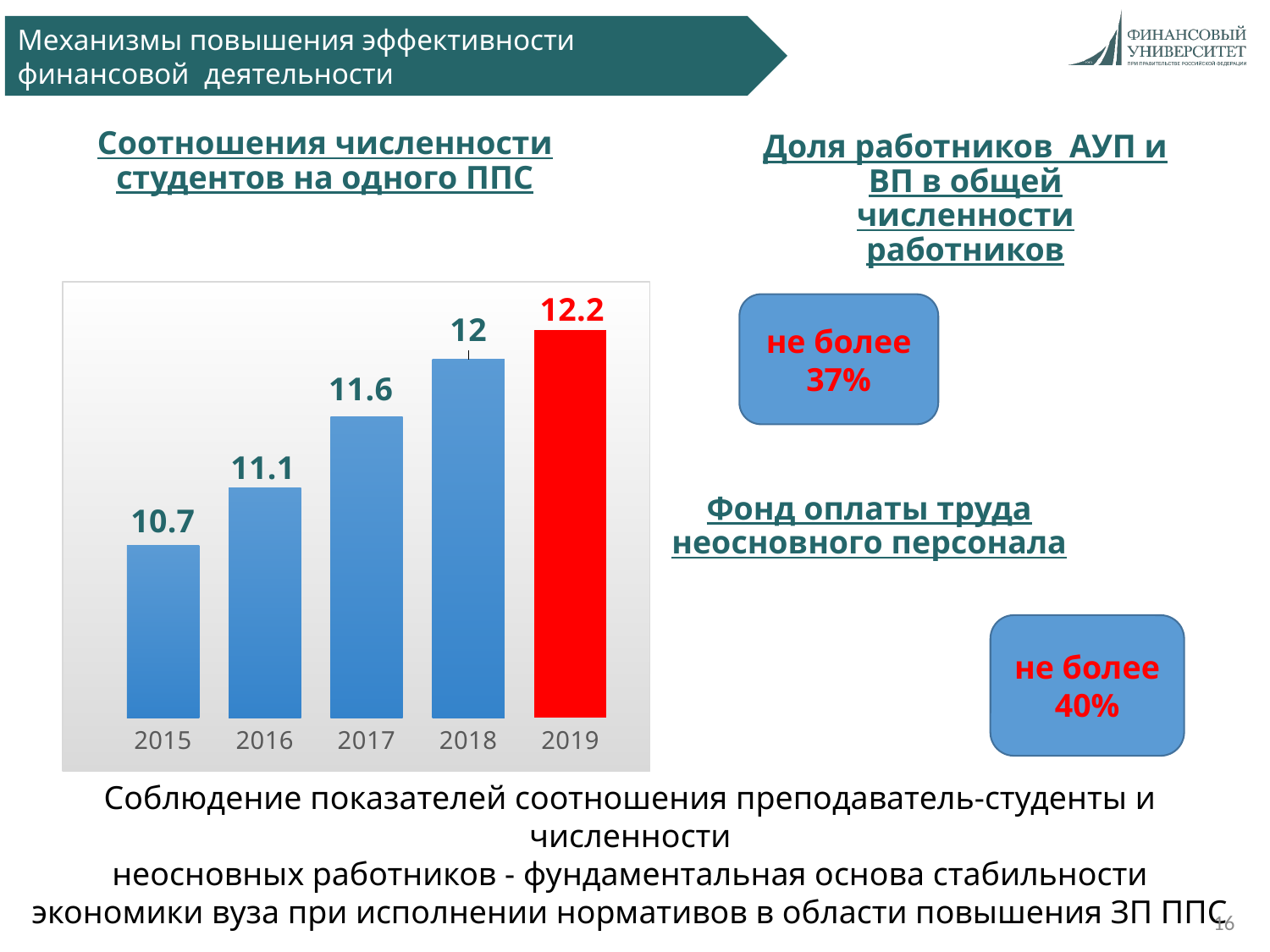
Which is larger, the value for 2016 or the value for 2018? 2018 What is the value for 2017 in the chart? 11.6 What is the value for 2019 in the chart? 12.2 Which year has the highest value in the chart? 2019 Which year has the lowest value in the chart? 2015 How many years are shown in the chart? 5 What kind of chart is shown on the slide? bar chart Do the values rise or fall from 2015 to 2019? rise What is the difference between the values for 2019 and 2015? 1.5 What is the value for 2015 in the chart? 10.7 Which bar in the chart is coloured red? 2019 What is the difference between the values for 2018 and 2016? 0.9